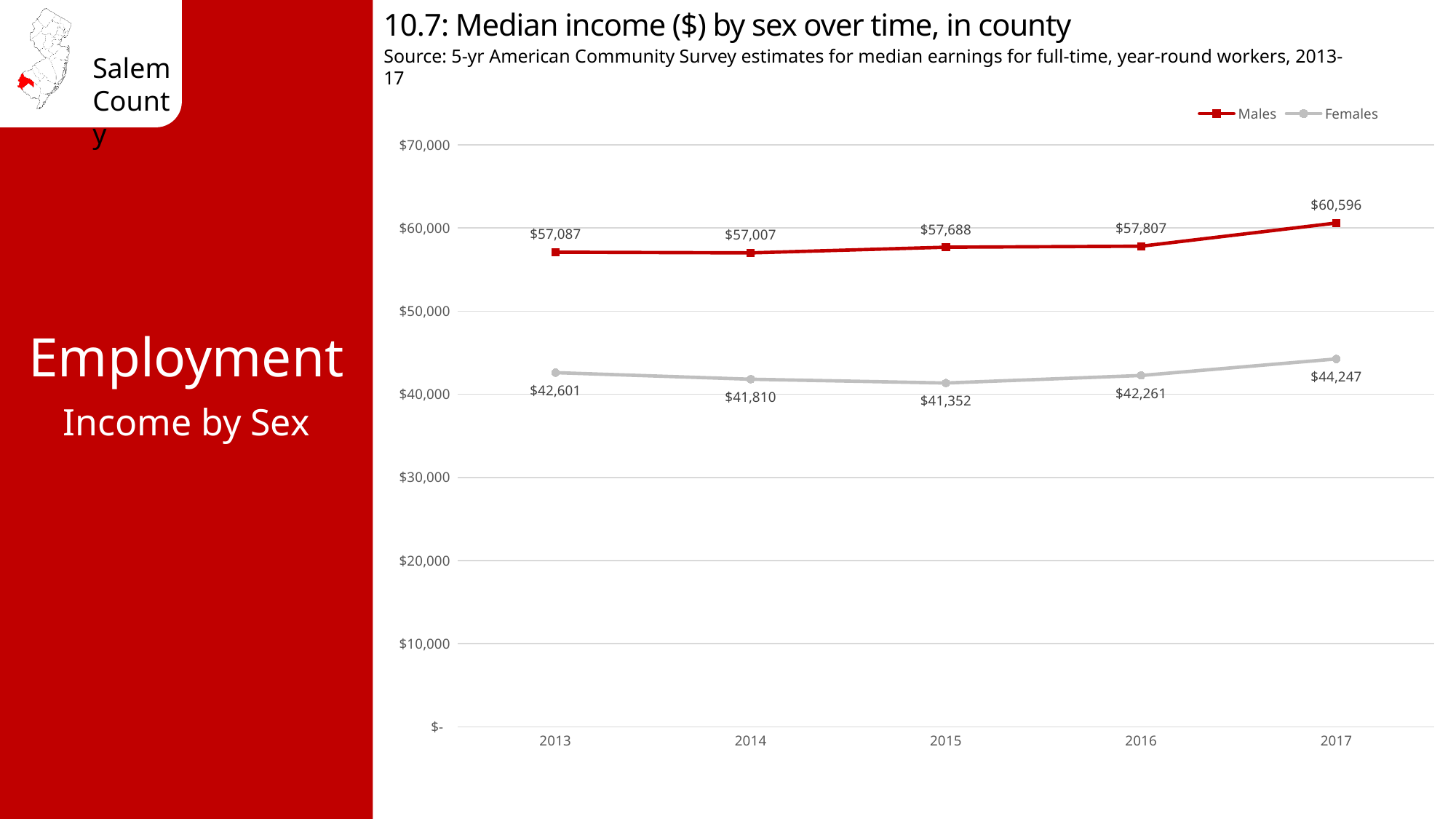
What was the median income for Males in 2017? $60,596 Is the median income for Males in 2017 greater or less than $60,000? greater Which was higher in 2016, the median income for Males or for Females? Males What was the median income for Females in 2015? $41,352 How many years are shown on the x axis? 5 In which year was the median income for Males highest? 2017 What is the difference between the Males and Females median income in 2017? $16,349 What was the median income for Males in 2014? $57,007 How many series does the legend list? 2 What kind of chart is shown on the slide? line chart What is the difference between the Females median income in 2017 and in 2013? $1,646 In which year was the median income for Females lowest? 2015